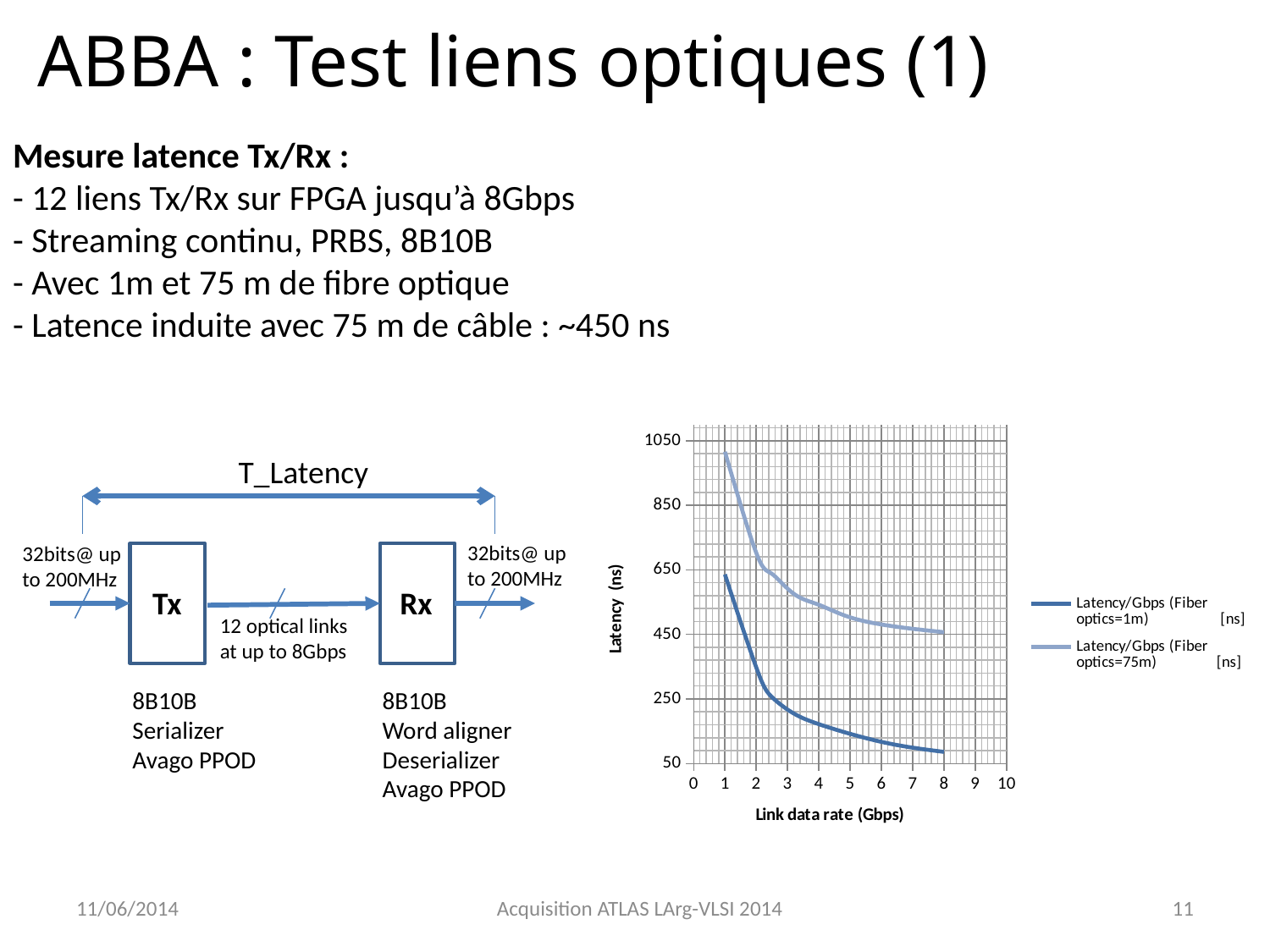
What is the title of the y axis of the chart? Latency (ns) What is the highest value shown on the y axis of the chart? 1050 How many series does the chart legend list? 2 As the link data rate increases, does the latency for the 1m fiber optics series rise or fall? fall At 4 Gbps, which series has the higher latency: Fiber optics=1m or Fiber optics=75m? Fiber optics=75m What kind of chart is shown on the slide? line chart Is the latency for the 1m fiber optics series at 8 Gbps greater or less than 250? less Is the latency for the 1m fiber optics series at 4 Gbps greater or less than 250? less What is the title of the x axis of the chart? Link data rate (Gbps) Is the latency for the 75m fiber optics series at 4 Gbps greater or less than 650? less As the link data rate increases, does the latency for the 75m fiber optics series rise or fall? fall